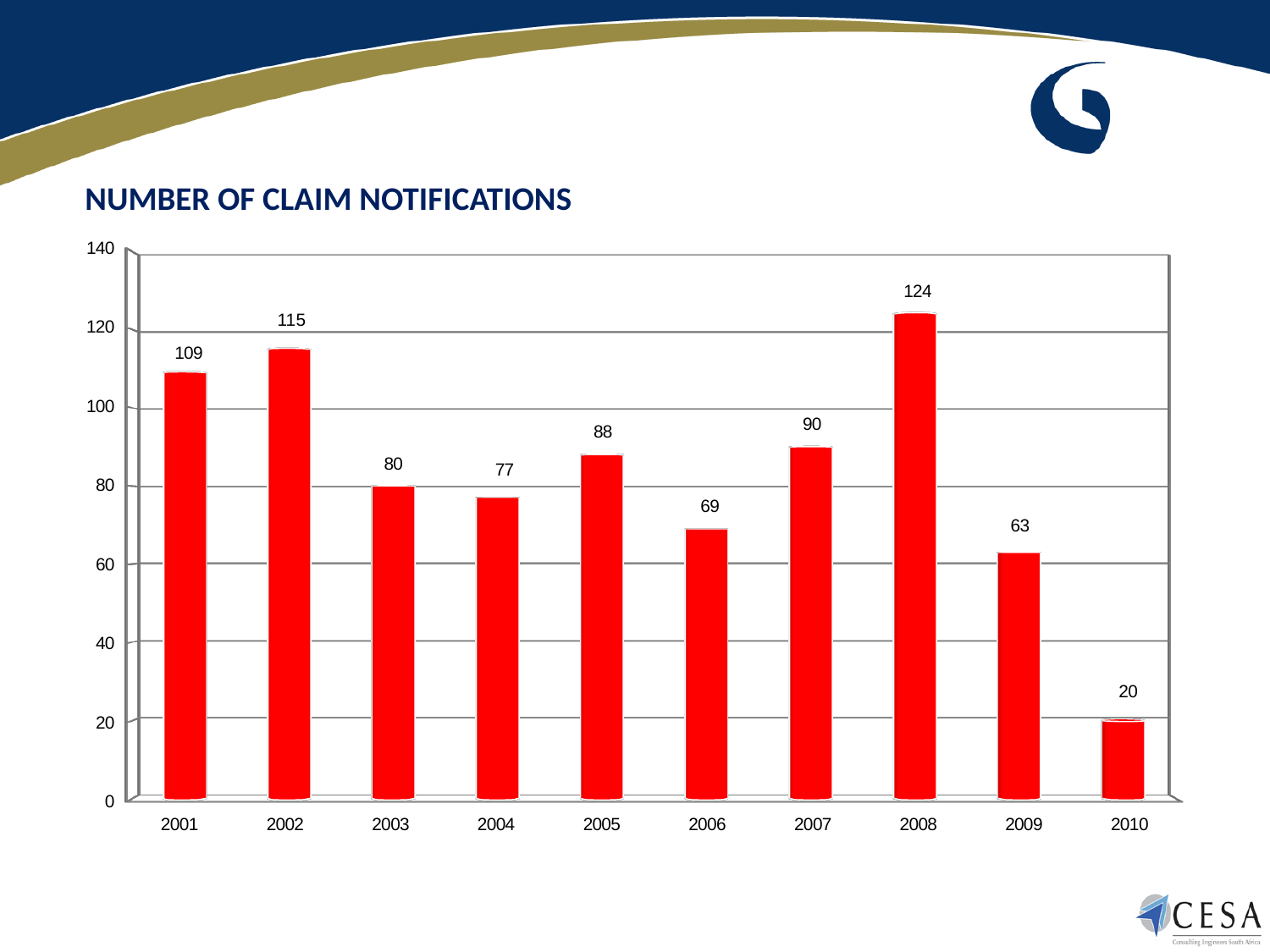
How many years are shown on the x axis of the chart? 10 Which year has the highest number of claim notifications? 2008 What kind of chart is shown on the slide? bar chart Which year has more claim notifications, 2005 or 2007? 2007 What is the title of the chart? NUMBER OF CLAIM NOTIFICATIONS Do the values rise or fall from 2008 to 2010? fall What is the number of claim notifications for 2008? 124 What colour are the bars in the chart? red What is the difference between the number of claim notifications in 2002 and 2003? 35 What is the number of claim notifications for 2004? 77 Is the value for 2006 greater or less than 80? less Which year has the lowest number of claim notifications? 2010